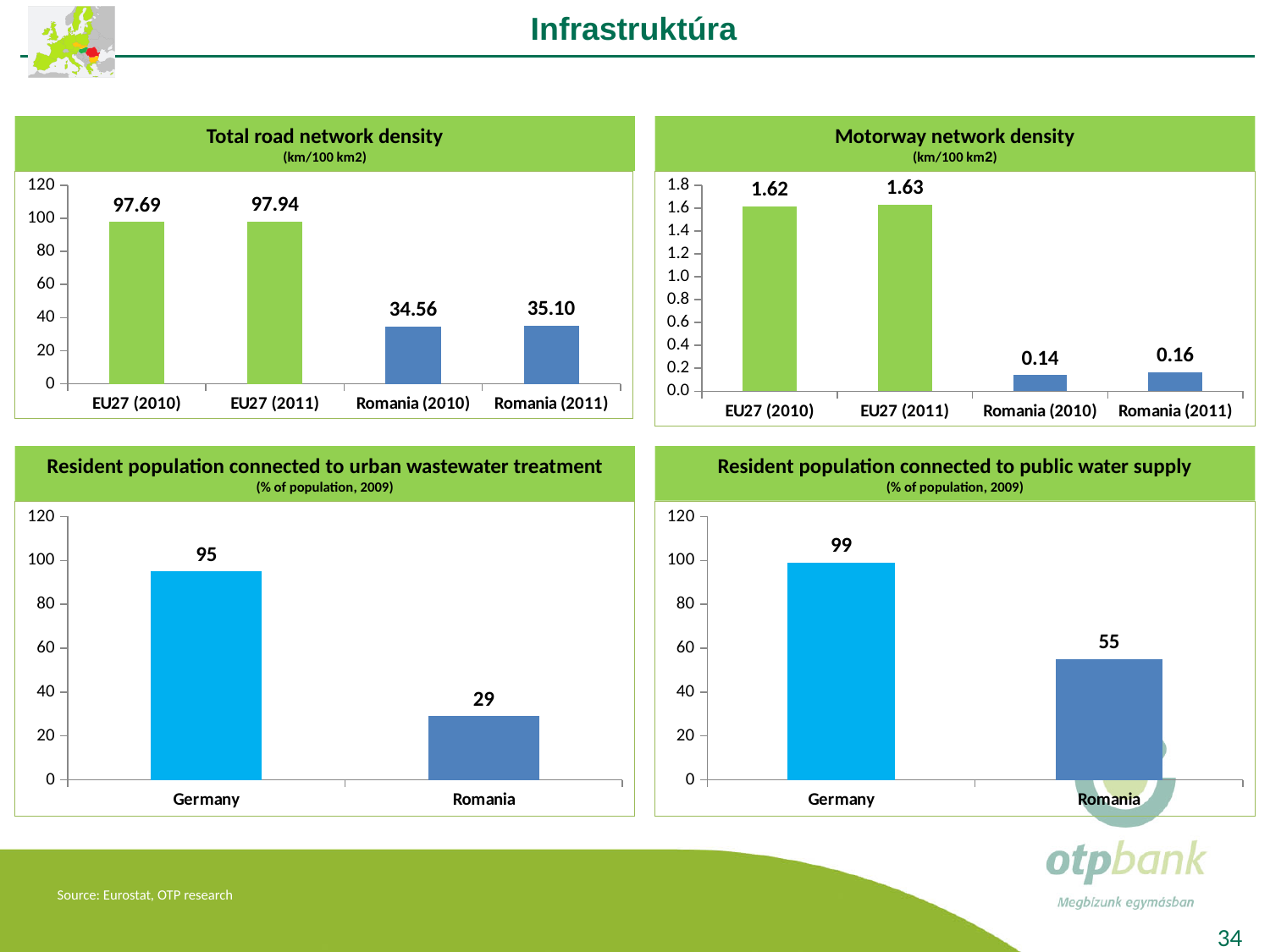
In the 'Resident population connected to public water supply' chart, which is larger, Germany or Romania? Germany In the 'Motorway network density' chart, which category has the highest value? EU27 (2011) In the 'Motorway network density' chart, what is the value for Romania (2011)? 0.16 In the 'Total road network density' chart, what is the value for EU27 (2011)? 97.94 In the 'Total road network density' chart, is the value for Romania (2011) greater or less than 40? less In the 'Total road network density' chart, what is the difference between EU27 (2010) and Romania (2010)? 63.13 What kind of chart is the 'Resident population connected to public water supply' chart? Bar chart In the 'Resident population connected to urban wastewater treatment' chart, what is the difference between Germany and Romania? 66 In the 'Motorway network density' chart, how many categories are shown? 4 In the 'Resident population connected to public water supply' chart, what is the value for Germany? 99 In the 'Total road network density' chart, which category has the lowest value? Romania (2010) In the 'Resident population connected to urban wastewater treatment' chart, what is the value for Romania? 29